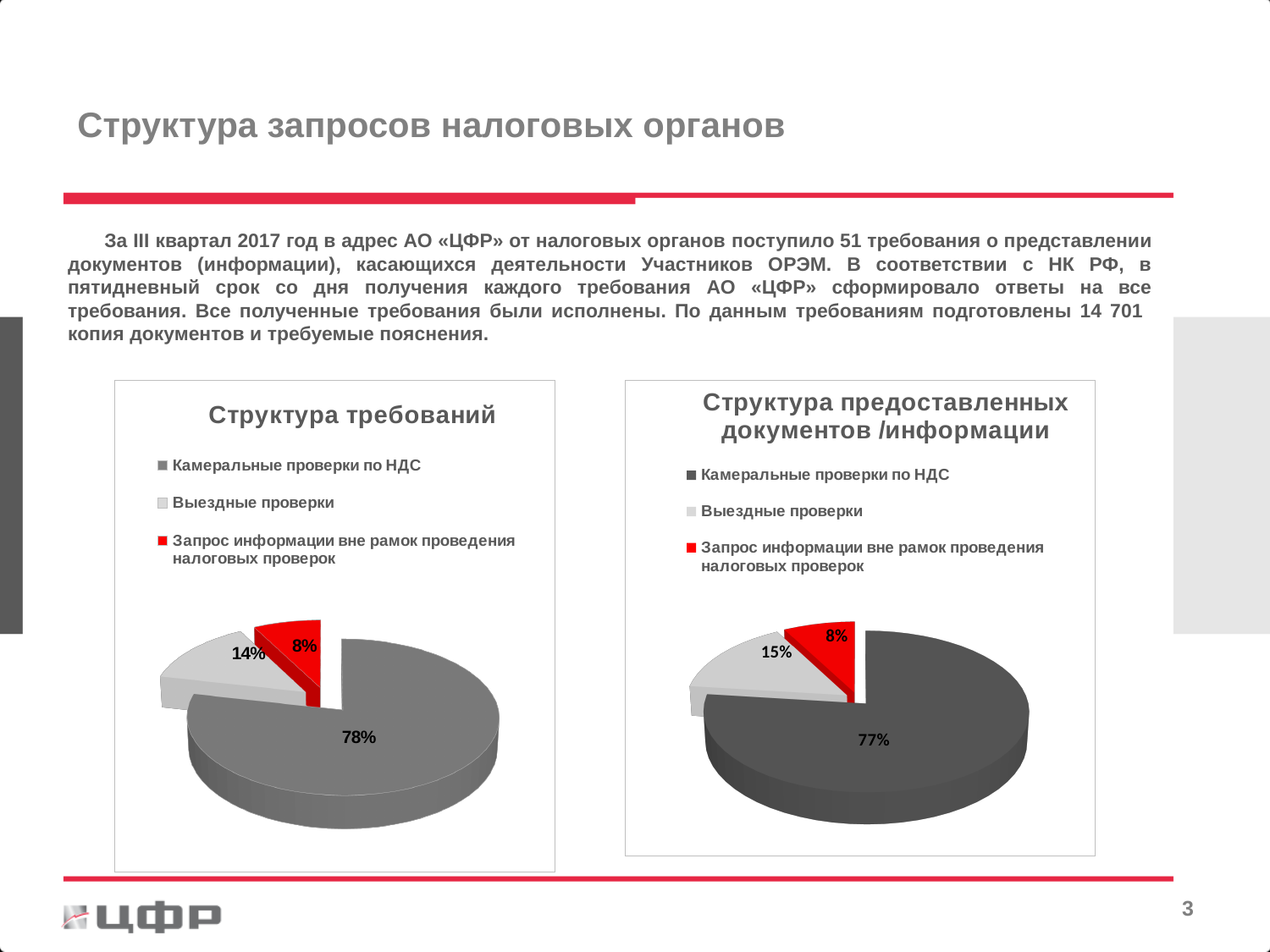
In the chart titled «Структура предоставленных документов /информации», what share is shown for «Выездные проверки»? 15% In the chart titled «Структура требований», what is the difference in percentage points between «Камеральные проверки по НДС» and «Выездные проверки»? 64 In the chart titled «Структура предоставленных документов /информации», what share is shown for «Камеральные проверки по НДС»? 77% In the chart titled «Структура требований», which category has the largest share? Камеральные проверки по НДС In the chart titled «Структура требований», what share is shown for «Камеральные проверки по НДС»? 78% What type of chart is the chart titled «Структура предоставленных документов /информации»? Pie chart How many slices does the chart titled «Структура требований» have? 3 In the chart titled «Структура предоставленных документов /информации», which category has the smallest share? Запрос информации вне рамок проведения налоговых проверок In the chart titled «Структура требований», what colour is the slice for «Запрос информации вне рамок проведения налоговых проверок»? Red In the chart titled «Структура предоставленных документов /информации», which is larger: «Выездные проверки» or «Запрос информации вне рамок проведения налоговых проверок»? Выездные проверки In the chart titled «Структура требований», what share is shown for «Выездные проверки»? 14% In the chart titled «Структура требований», what share is shown for «Запрос информации вне рамок проведения налоговых проверок»? 8%